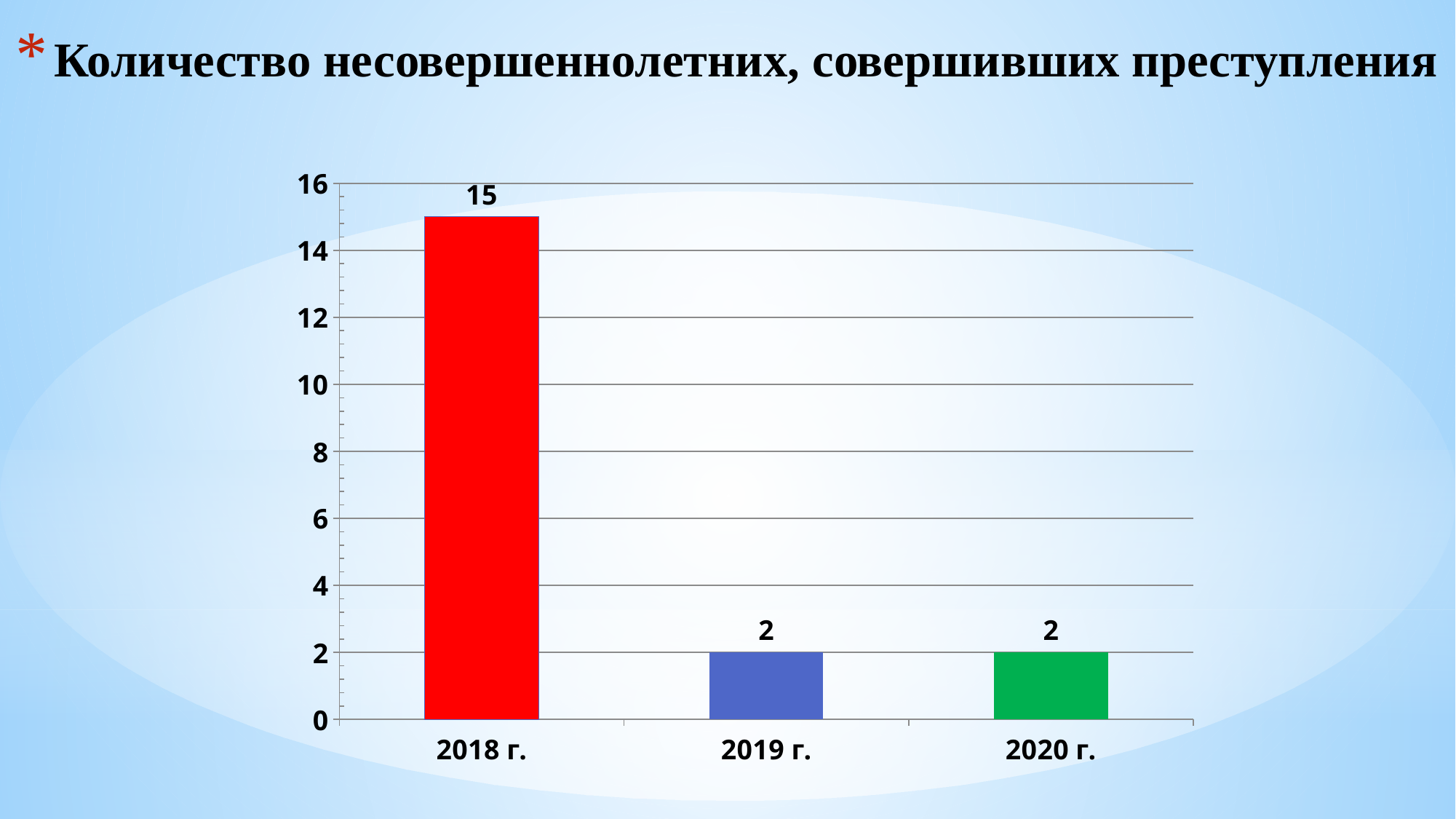
What colour is the bar for 2018 г.? red What is the value for 2018 г.? 15 What kind of chart is shown on the slide? bar chart Is the value for 2018 г. greater or less than 10? greater What is the difference between the values for 2018 г. and 2019 г.? 13 Do the values rise or fall from 2018 г. to 2019 г.? fall Which is larger, the value for 2018 г. or the value for 2020 г.? 2018 г. What is the value for 2020 г.? 2 How many categories are shown on the x axis? 3 Which year has the highest value? 2018 г. Is the value for 2019 г. greater or less than 4? less What is the value for 2019 г.? 2